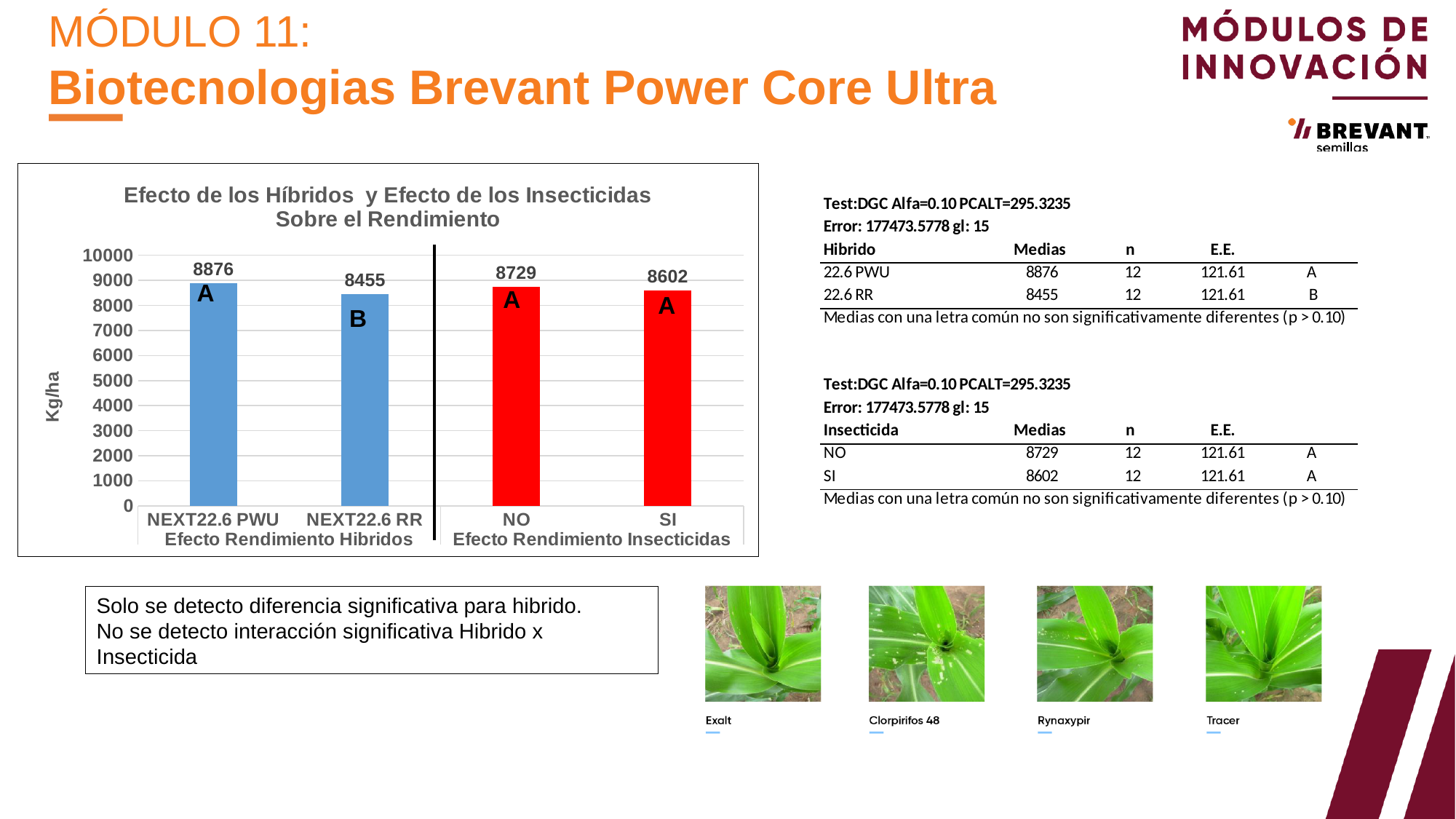
What kind of chart is shown? bar chart What is the difference between the values for NEXT22.6 PWU and NEXT22.6 RR? 421 What is the value for NO in the Efecto Rendimiento Insecticidas group? 8729 What is the label of the vertical axis? Kg/ha What is the difference between the values for NO and SI? 127 What is the value for SI in the Efecto Rendimiento Insecticidas group? 8602 What is the value for NEXT22.6 RR? 8455 What is the value for NEXT22.6 PWU? 8876 Which category has the highest value? NEXT22.6 PWU Which category has the lowest value? NEXT22.6 RR How many bars are plotted in the chart? 4 Which is larger, the value for NO or the value for SI? NO